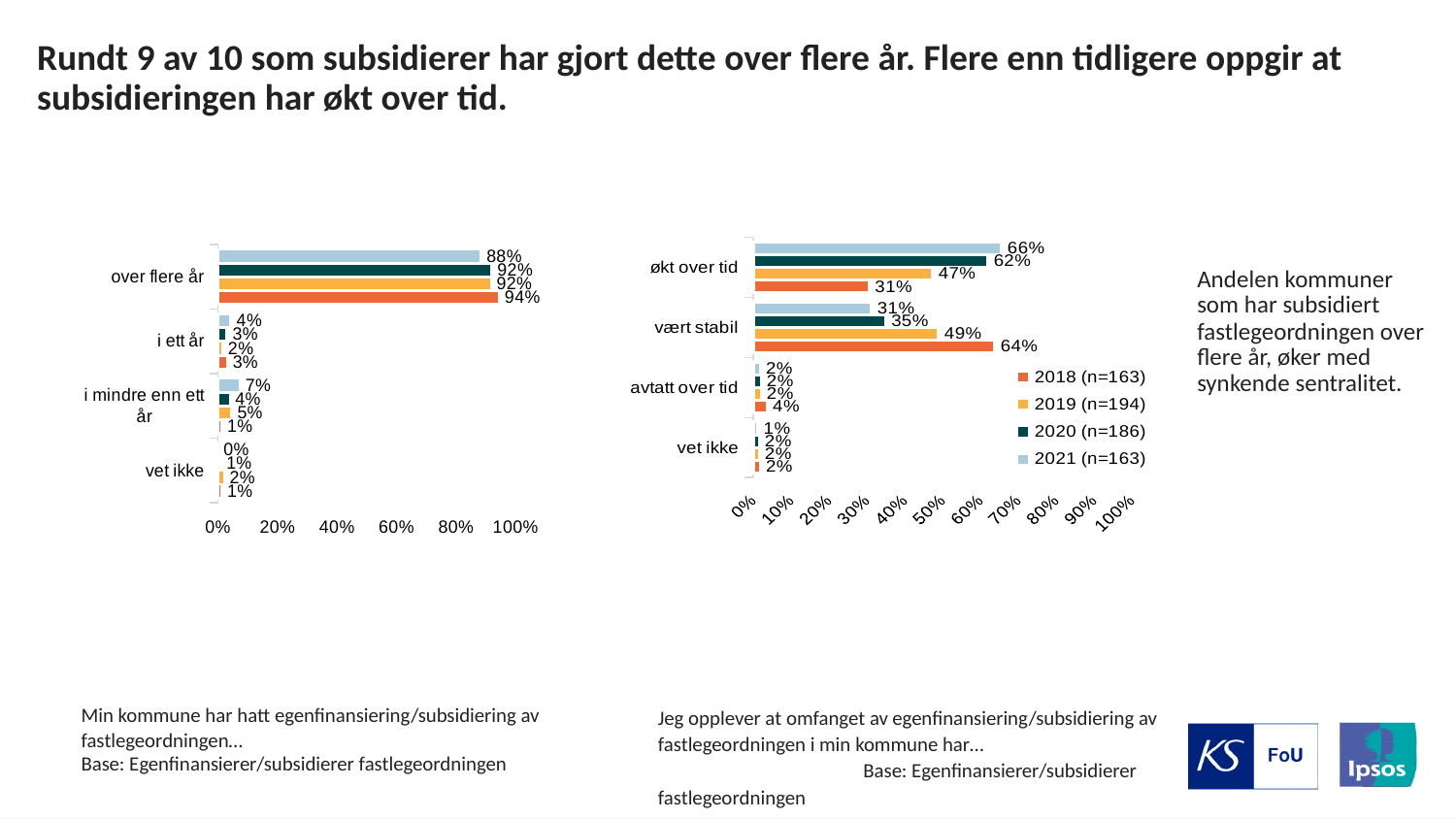
In the right chart, which category has the highest value in the 2020 (n=186) series? økt over tid In the right chart, what is the value for 'vært stabil' in the 2018 (n=163) series? 64% In the left chart, what is the value of the top bar for 'i mindre enn ett år'? 7% In the right chart, what sample size is shown in the legend for 2019? n=194 In the right chart, how many series does the legend list? 4 In the right chart, what is the value for 'økt over tid' in the 2019 (n=194) series? 47% In the right chart, what is the difference between the 2021 (n=163) and 2018 (n=163) values for 'økt over tid'? 35 percentage points In the left chart, what is the value of the bottom bar for 'over flere år'? 94% In the right chart, how many categories are shown on the vertical axis? 4 In the right chart, for 'vært stabil', which is larger: the 2018 (n=163) value or the 2021 (n=163) value? 2018 (n=163) What kind of chart is the left chart? Bar chart In the right chart, what is the value for 'økt over tid' in the 2021 (n=163) series? 66%